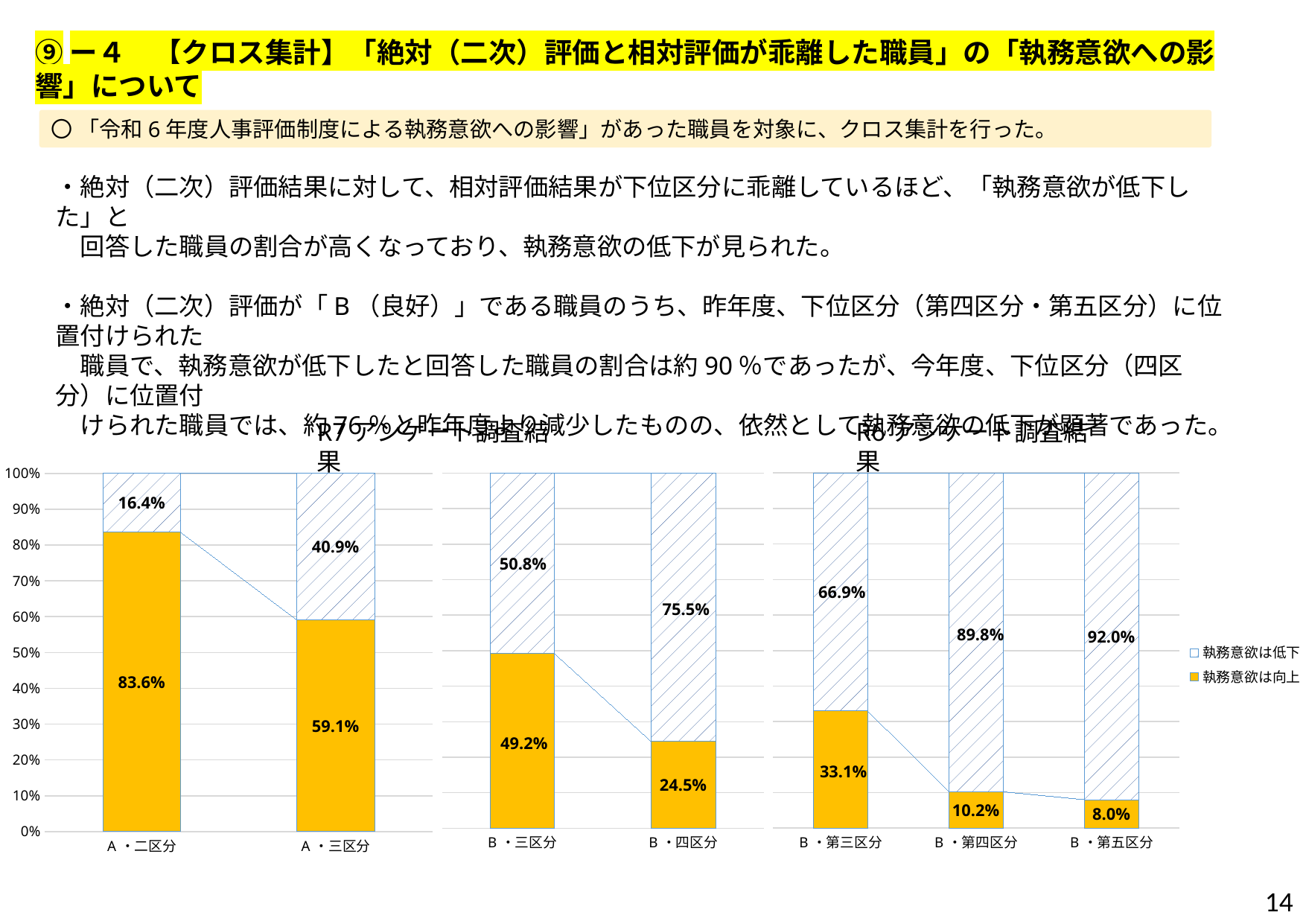
In the left chart, which is larger: 執務意欲は向上 for A・二区分 or for A・三区分? A・二区分 In the left chart, what is the value of 執務意欲は低下 for A・三区分? 40.9% What kind of chart is the middle chart? Stacked bar chart In the right chart, does the value of 執務意欲は向上 rise or fall from B・第三区分 to B・第五区分? Fall In the left chart, what is the value of 執務意欲は向上 for A・二区分? 83.6% How many series does the legend list? 2 In the middle chart, what is the difference between the 執務意欲は向上 values for B・三区分 and B・四区分? 24.7% In the right chart, which category has the lowest value for 執務意欲は向上? B・第五区分 In the right chart, which category has the highest value for 執務意欲は低下? B・第五区分 How many categories are shown in the right chart? 3 In the right chart, what is the value of 執務意欲は向上 for B・第五区分? 8.0% In the middle chart, what is the value of 執務意欲は低下 for B・四区分? 75.5%